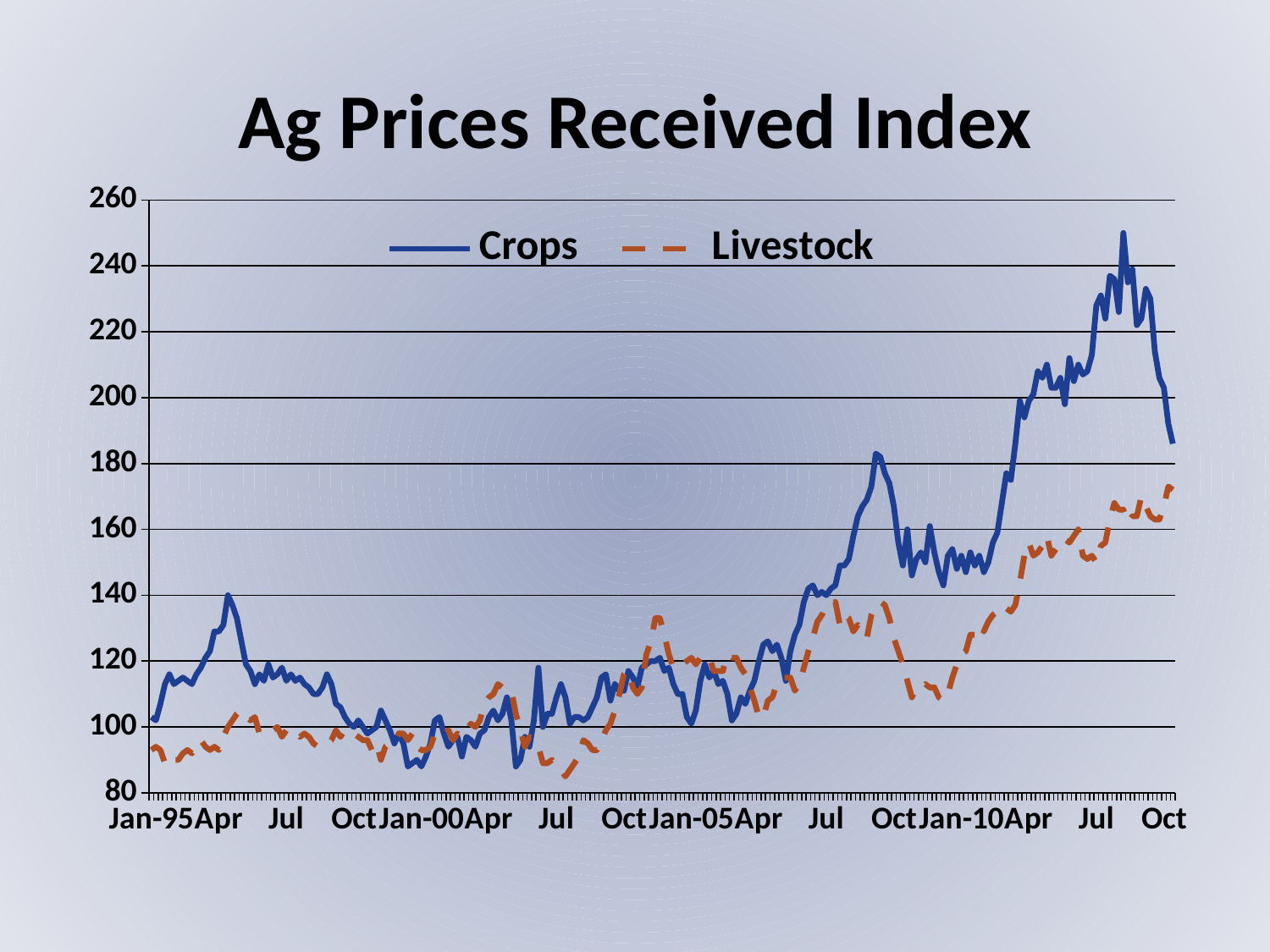
What is the title of the chart? Ag Prices Received Index Overall, do the Crops values rise or fall from Jan-95 to the end of the x axis? rise Is the peak value of the Crops series greater or less than 240? greater What kind of chart is shown on the slide? line chart Which series is drawn with a dashed line? Livestock Is the highest value of the Livestock series greater or less than 180? less How many series does the legend list? 2 Is the value for Crops at Jan-10 greater or less than 140? greater At Jan-10, which series has the higher value, Crops or Livestock? Crops At the last point on the x axis (Oct), which series has the higher value, Crops or Livestock? Crops Which series reaches the highest value on the chart? Crops